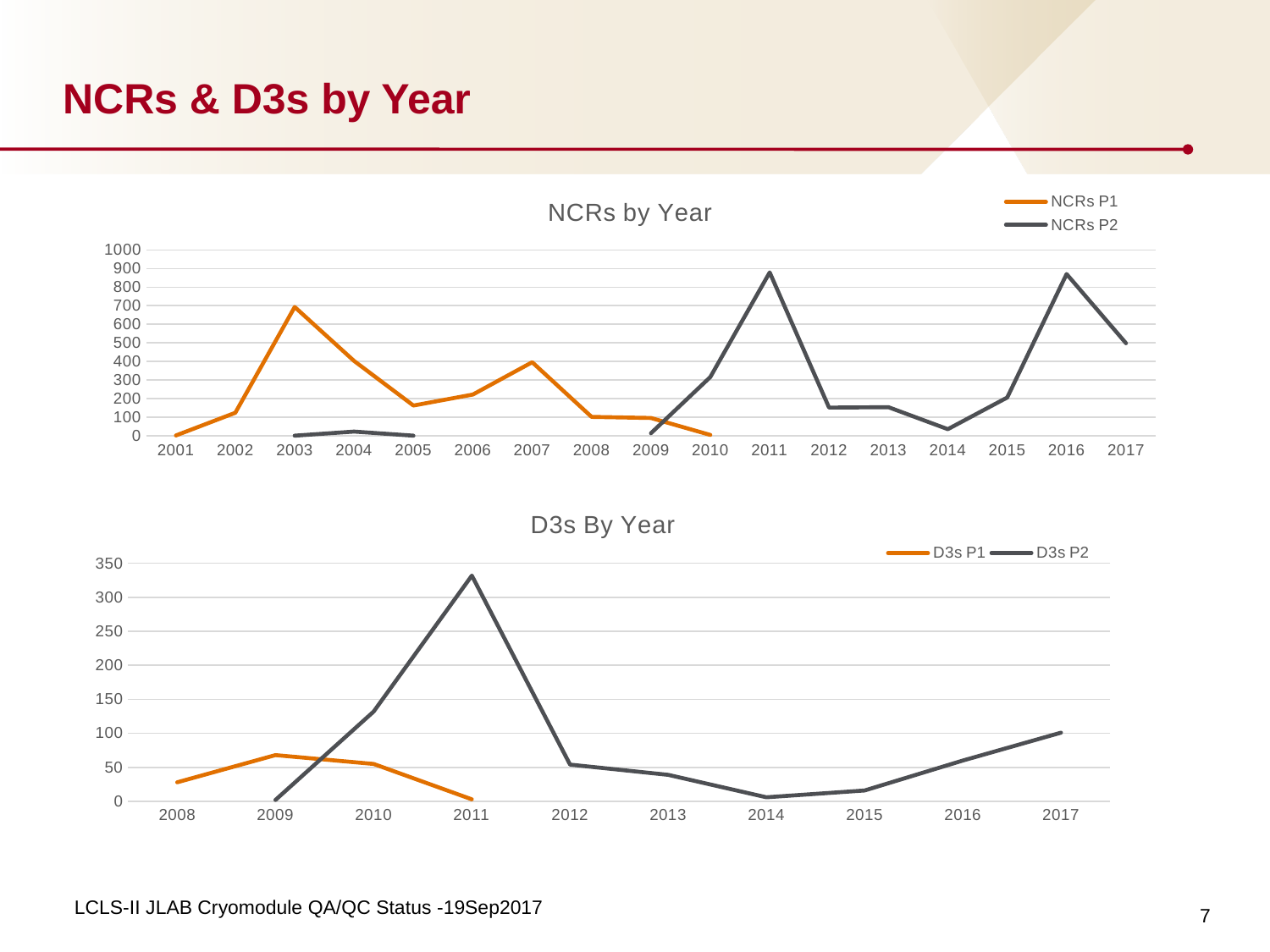
In the 'D3s By Year' chart, in which year does D3s P2 reach its highest value? 2011 In the 'NCRs by Year' chart, is the value for NCRs P2 in 2014 greater or less than 100? less In the 'NCRs by Year' chart, is the value for NCRs P2 in 2011 greater or less than 800? greater How many series does the legend of the 'NCRs by Year' chart list? 2 In the 'NCRs by Year' chart, in which year does NCRs P1 reach its highest value? 2003 In the 'NCRs by Year' chart, which is larger: NCRs P1 in 2003 or NCRs P1 in 2005? 2003 How many years are shown on the x axis of the 'NCRs by Year' chart? 17 In the 'NCRs by Year' chart, is the value for NCRs P1 in 2003 greater or less than 600? greater In the 'D3s By Year' chart, do the D3s P2 values rise or fall from 2014 to 2017? rise How many years are shown on the x axis of the 'D3s By Year' chart? 10 What kind of chart is the 'NCRs by Year' chart? line chart